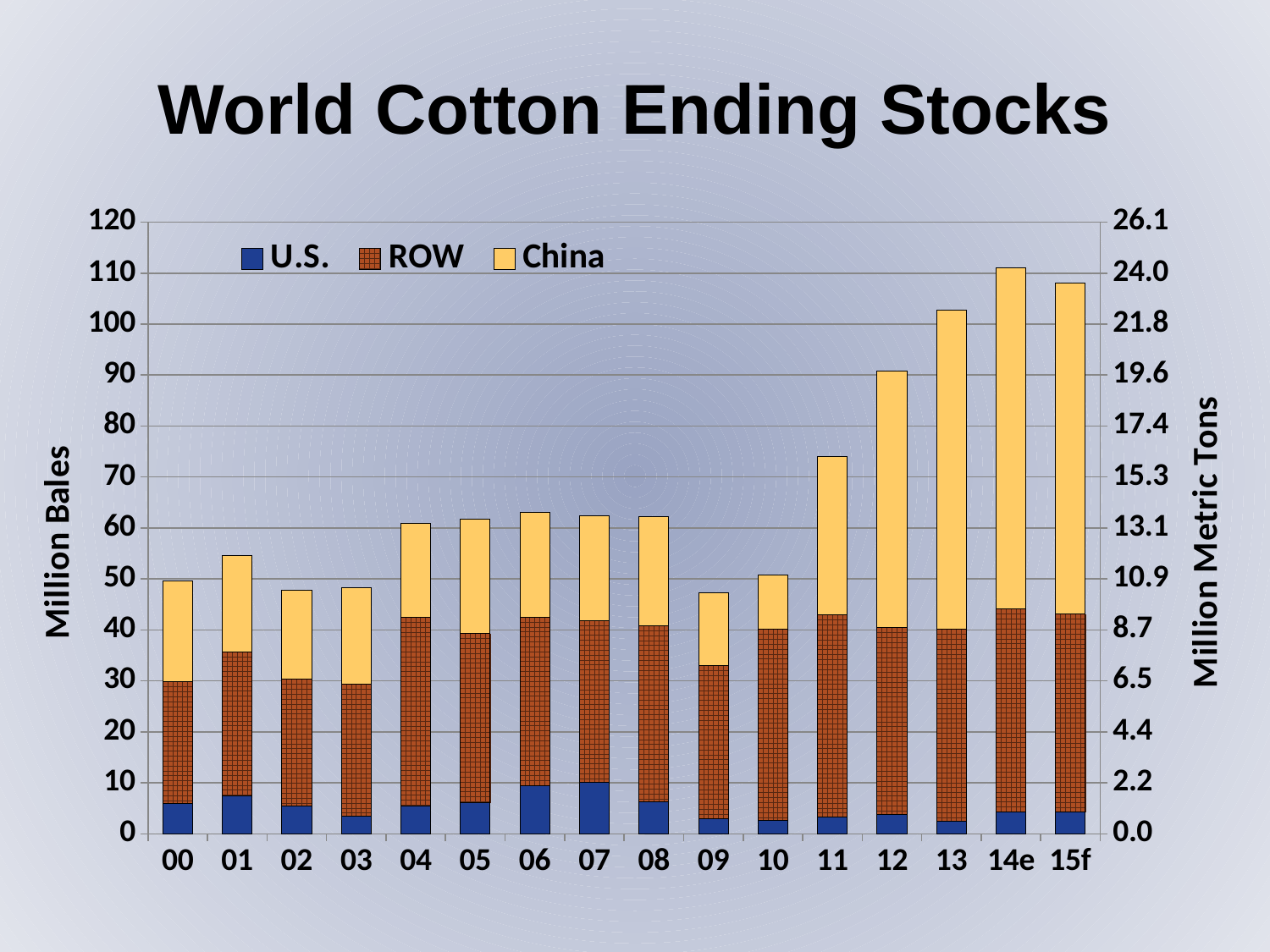
What is the label of the left vertical axis? Million Bales How many years (categories) are shown along the x axis? 16 How many series does the legend list? 3 Which year has the highest total ending stocks? 14e Is the total ending stocks for 14e greater or less than 100 million bales? greater Is the total ending stocks for 00 greater or less than 60 million bales? less What kind of chart is shown on the slide? Stacked bar chart Is the total ending stocks for 09 greater or less than 50 million bales? less Do total ending stocks rise or fall from 11 to 14e? rise Which year has the larger total ending stocks, 12 or 13? 13 What is the title of the chart? World Cotton Ending Stocks